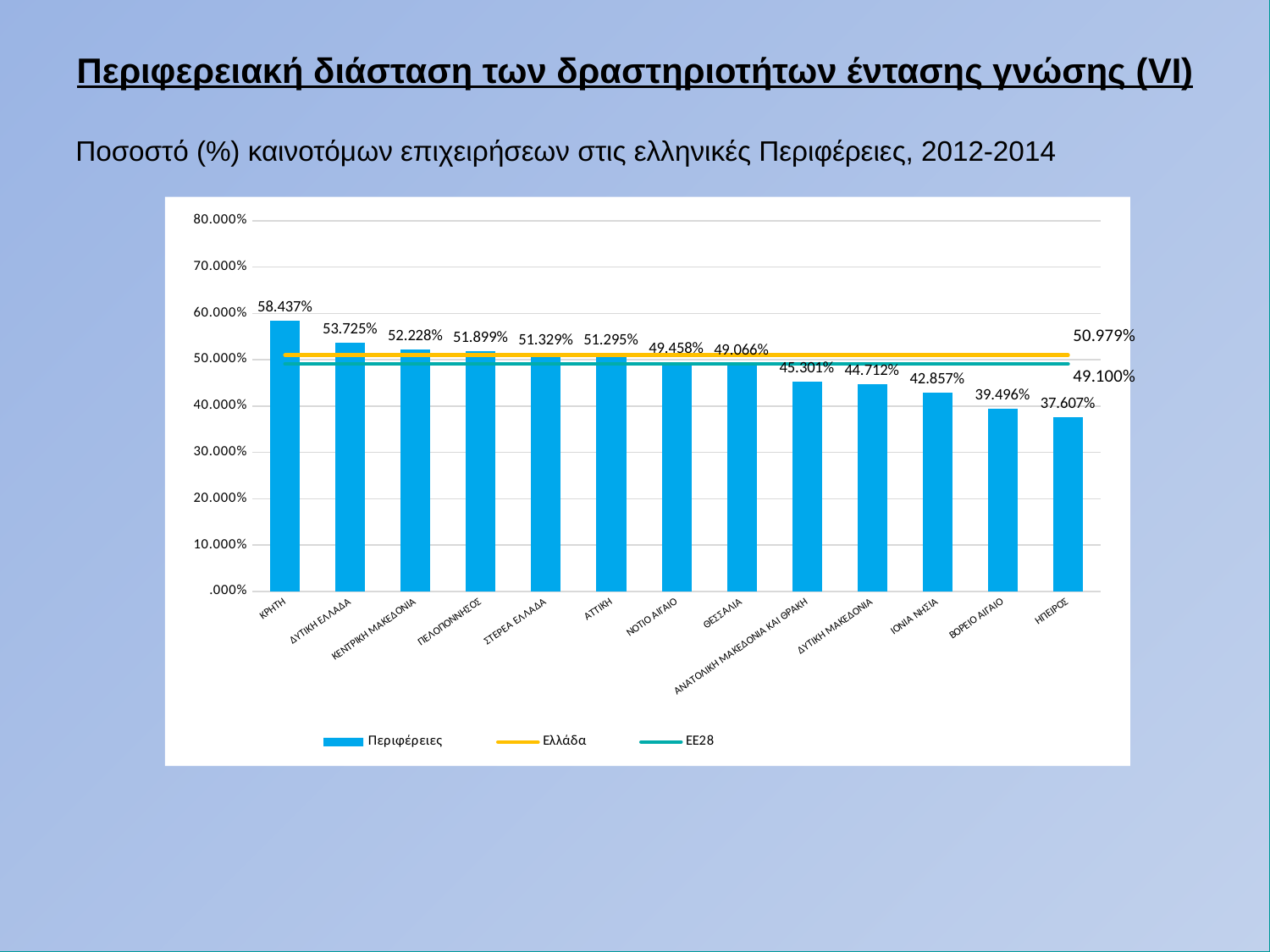
Which region has the lowest percentage of innovative enterprises? ΗΠΕΙΡΟΣ What is the value for ΑΤΤΙΚΗ? 51.295% How many regions are shown on the x axis? 13 Which region has the highest percentage of innovative enterprises? ΚΡΗΤΗ What is the value for ΚΡΗΤΗ? 58.437% What is the difference between the values for ΚΡΗΤΗ and ΗΠΕΙΡΟΣ? 20.830 percentage points Which is larger, the value for ΘΕΣΣΑΛΙΑ or the value for ΔΥΤΙΚΗ ΜΑΚΕΔΟΝΙΑ? ΘΕΣΣΑΛΙΑ What value is shown for the Ελλάδα line? 50.979% What is the value for ΙΟΝΙΑ ΝΗΣΙΑ? 42.857% How many series does the legend list? 3 Is the value for ΒΟΡΕΙΟ ΑΙΓΑΙΟ greater or less than 40.000%? less Do the bar values rise or fall from left to right along the x axis? fall